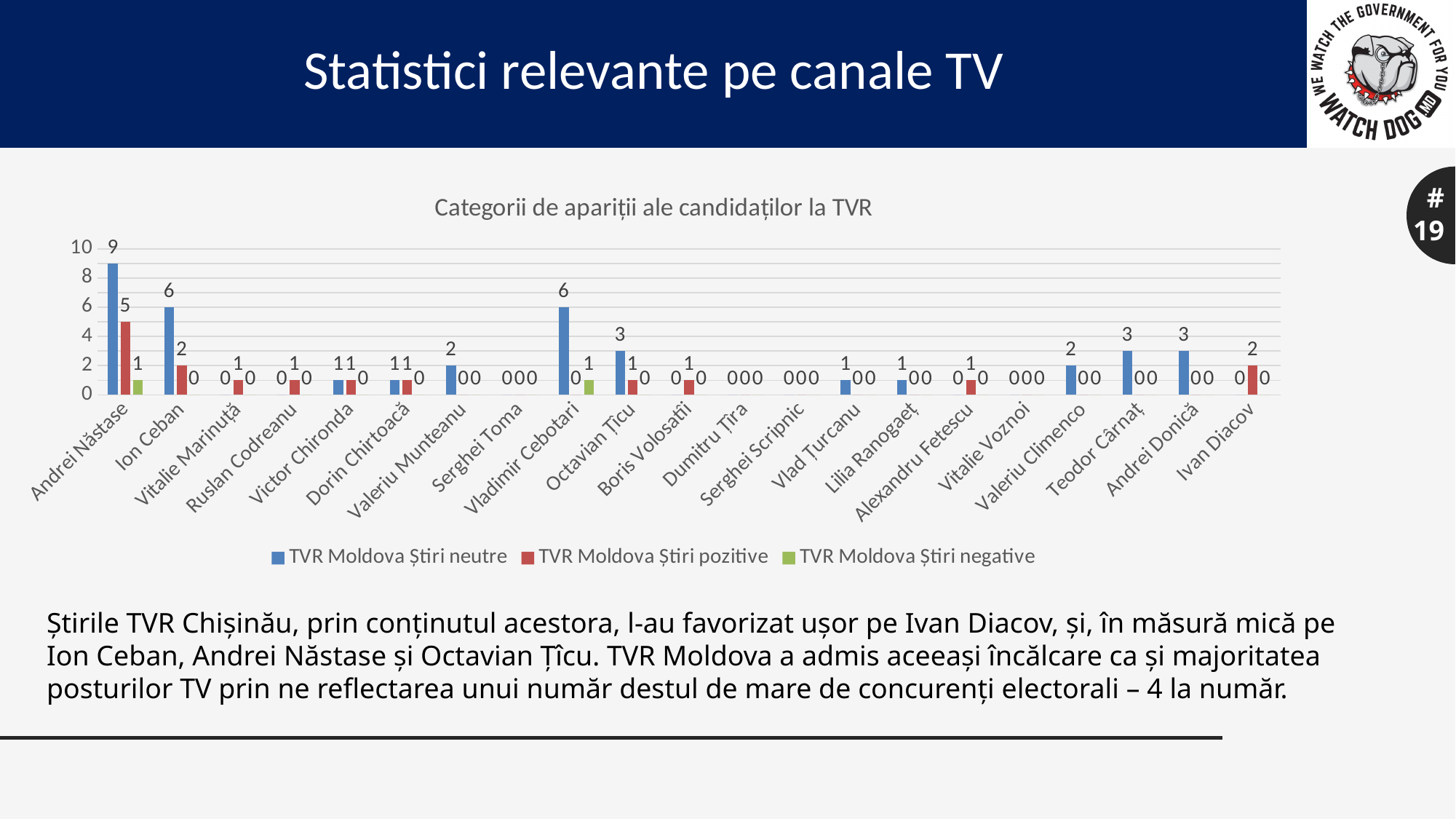
What is the value of TVR Moldova Știri pozitive for Ion Ceban? 2 What is the value of TVR Moldova Știri neutre for Andrei Năstase? 9 How many candidates are shown on the x axis of the chart? 21 What is the value of TVR Moldova Știri pozitive for Ivan Diacov? 2 Which candidate has the highest value for TVR Moldova Știri pozitive? Andrei Năstase Which colour represents TVR Moldova Știri negative in the chart? Green Which is larger: the TVR Moldova Știri neutre value for Vladimir Cebotari or for Octavian Țîcu? Vladimir Cebotari Which candidate has the highest value for TVR Moldova Știri neutre? Andrei Năstase How many series does the legend list? 3 What kind of chart is shown on the slide? Bar chart What is the title of the chart? Categorii de apariții ale candidaților la TVR What is the difference between the TVR Moldova Știri neutre values for Andrei Năstase and Ion Ceban? 3